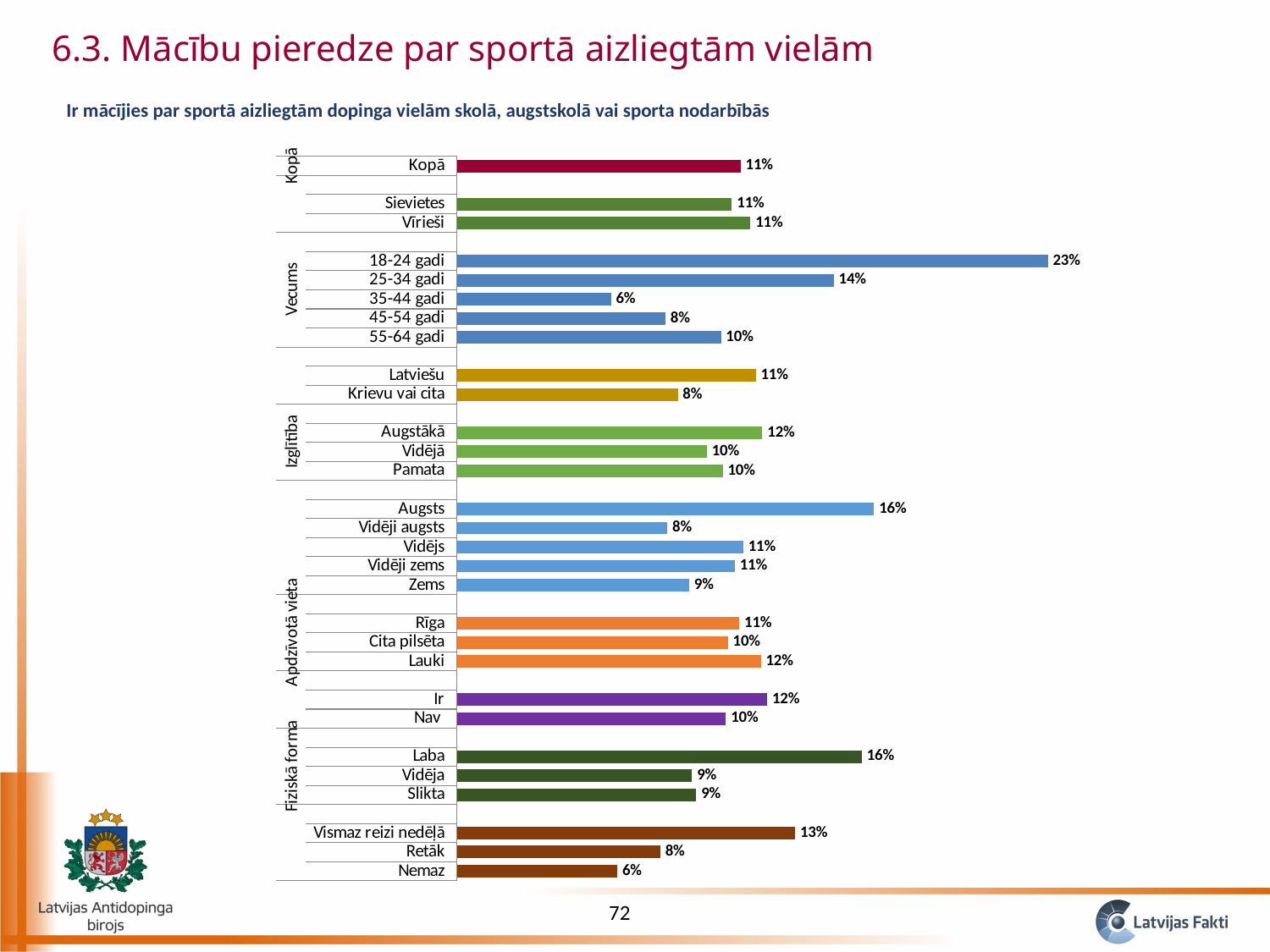
What is the difference between the values for 18-24 gadi and 25-34 gadi? 9% What is the difference between the values for Laba and Slikta? 7% How many bars are plotted in the chart? 29 Within the Vecums (age) group, which category has the lowest value? 35-44 gadi What is the value for Kopā? 11% What is the value for 18-24 gadi? 23% What is the value for Krievu vai cita? 8% What type of chart is shown on the slide? bar chart Which is larger, the value for Augsts or the value for Zems? Augsts Which category has the highest value in the chart? 18-24 gadi What is the subtitle text shown above the chart? Ir mācījies par sportā aizliegtām dopinga vielām skolā, augstskolā vai sporta nodarbībās What is the value for Vismaz reizi nedēļā? 13%